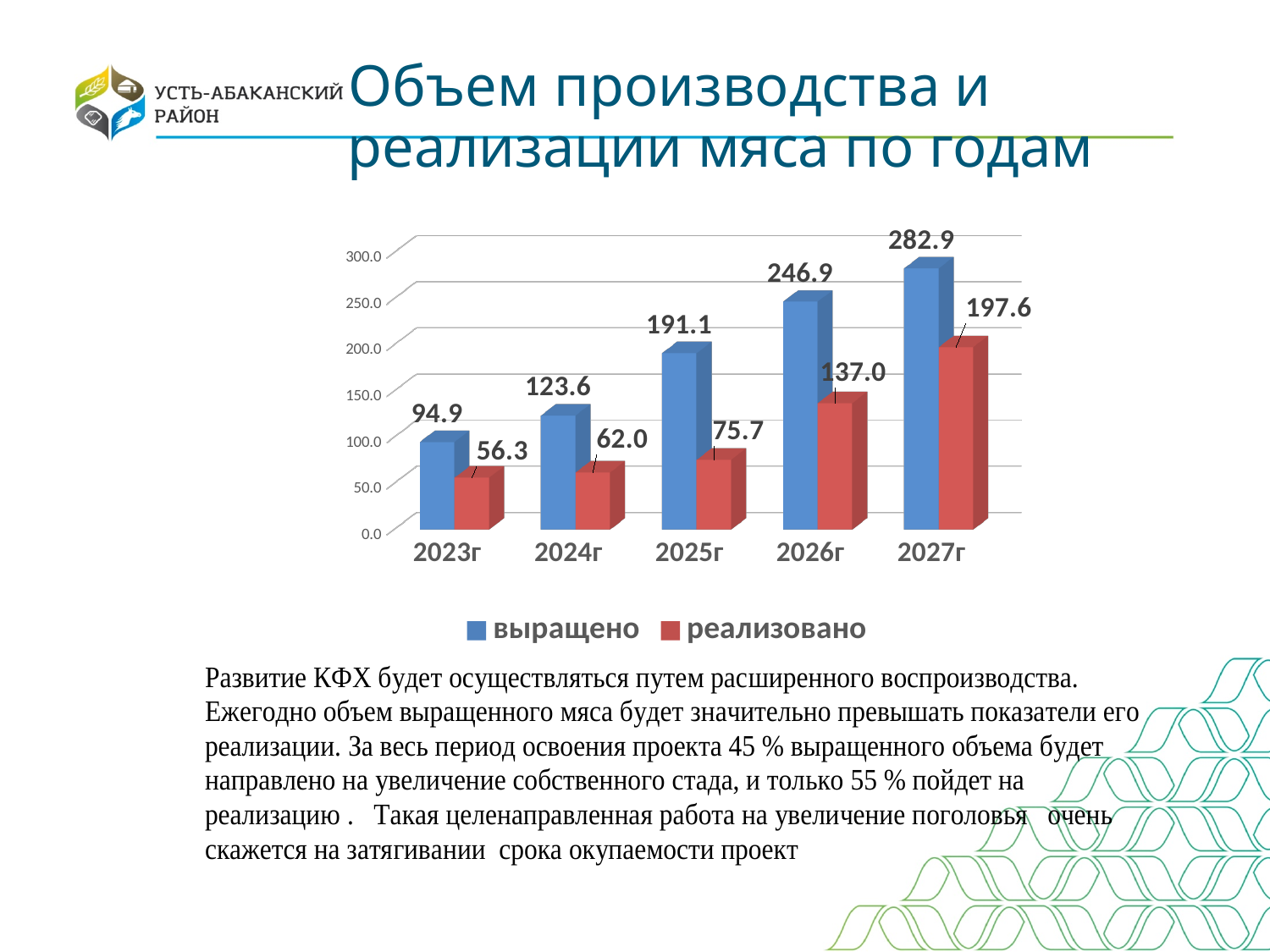
How many series does the legend list? 2 What kind of chart is shown on the slide? bar chart How many years are shown on the x axis? 5 Do the values of выращено rise or fall from 2023г to 2027г? rise What is the difference between выращено in 2024г and выращено in 2023г? 28.7 Which is larger: реализовано in 2027г or выращено in 2025г? реализовано in 2027г In which year is реализовано lowest? 2023г In which year is выращено highest? 2027г What is the value of выращено for 2025г? 191.1 What is the value of реализовано for 2023г? 56.3 What is the difference between выращено and реализовано in 2027г? 85.3 What is the value of реализовано for 2026г? 137.0